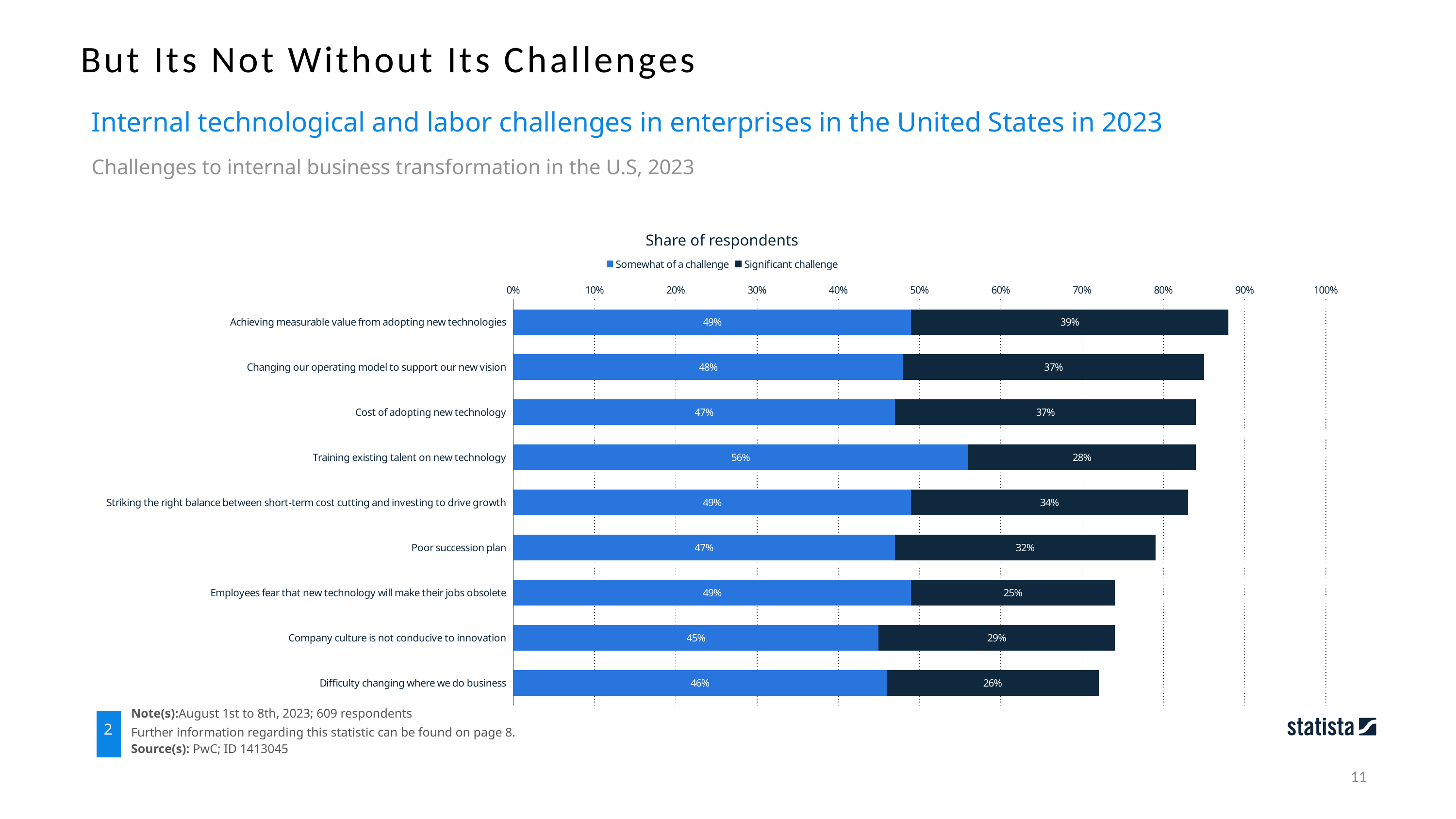
What is the title shown above the chart's legend? Share of respondents What is the 'Significant challenge' value for 'Poor succession plan'? 32% Which category has the lowest 'Significant challenge' value? Employees fear that new technology will make their jobs obsolete How many series does the legend list? 2 What share of respondents said 'Training existing talent on new technology' was somewhat of a challenge? 56% What is the difference between the 'Somewhat of a challenge' and 'Significant challenge' values for 'Training existing talent on new technology'? 28% Which is larger: the 'Significant challenge' value for 'Company culture is not conducive to innovation' or for 'Difficulty changing where we do business'? Company culture is not conducive to innovation How many categories are shown on the chart? 9 What kind of chart is shown on the slide? Stacked bar chart What share of respondents said 'Achieving measurable value from adopting new technologies' was a significant challenge? 39% Which category has the highest 'Somewhat of a challenge' value? Training existing talent on new technology What is the total of the stacked bar for 'Achieving measurable value from adopting new technologies'? 88%